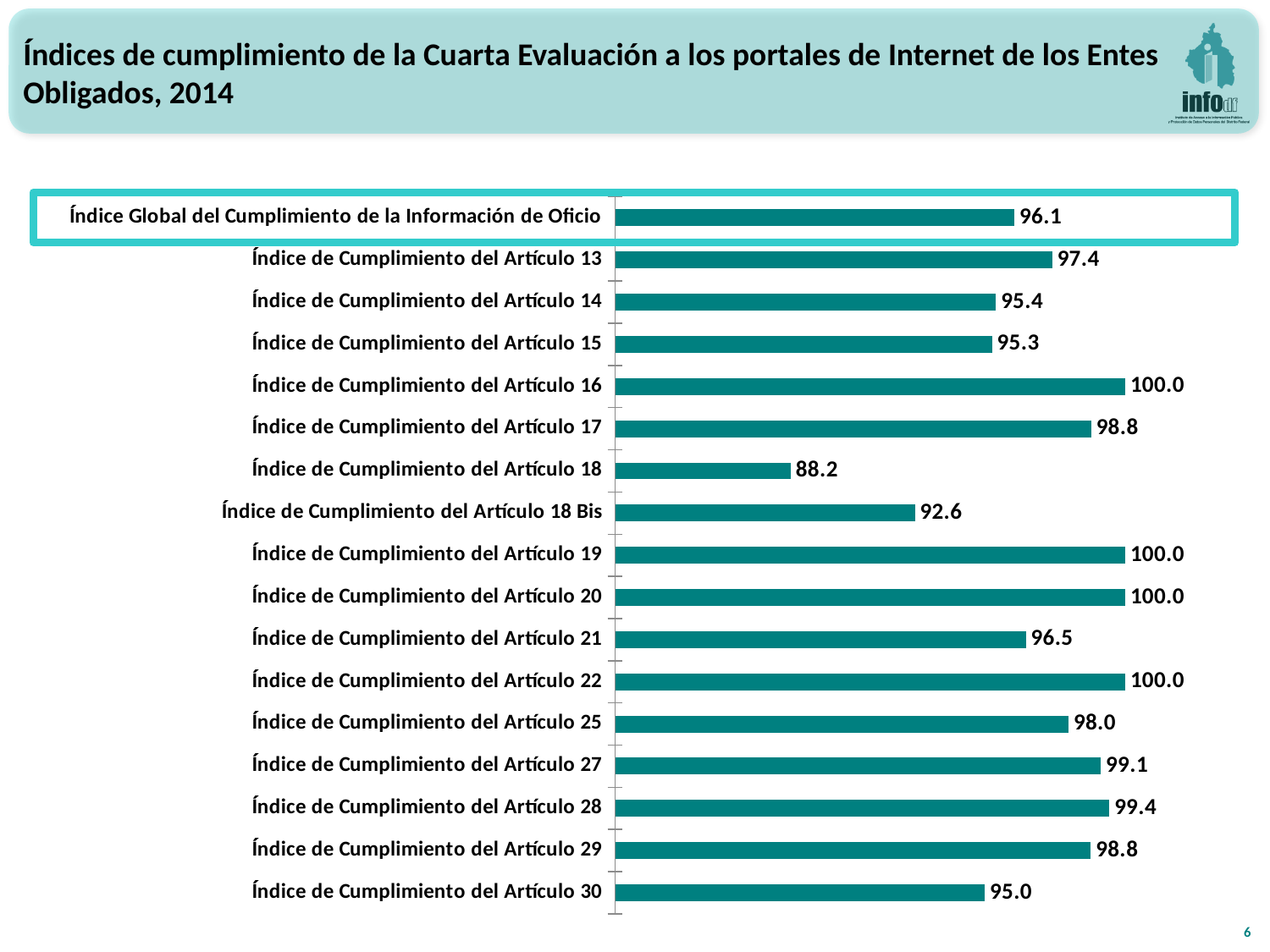
What kind of chart is shown on the slide? Bar chart Which is larger, the value for Índice de Cumplimiento del Artículo 17 or Índice de Cumplimiento del Artículo 25? Índice de Cumplimiento del Artículo 17 Which category has the lowest value? Índice de Cumplimiento del Artículo 18 What is the value for Índice de Cumplimiento del Artículo 28? 99.4 Which category is highlighted with a box on the chart? Índice Global del Cumplimiento de la Información de Oficio What is the value for Índice de Cumplimiento del Artículo 18 Bis? 92.6 What is the difference between the value for Índice de Cumplimiento del Artículo 13 and Índice de Cumplimiento del Artículo 14? 2.0 How many categories are shown on the chart? 17 What is the value for Índice Global del Cumplimiento de la Información de Oficio? 96.1 How many bars reach a value of 100.0? 4 What is the difference between the Índice Global del Cumplimiento de la Información de Oficio and Índice de Cumplimiento del Artículo 18? 7.9 What is the highest value shown on the chart? 100.0